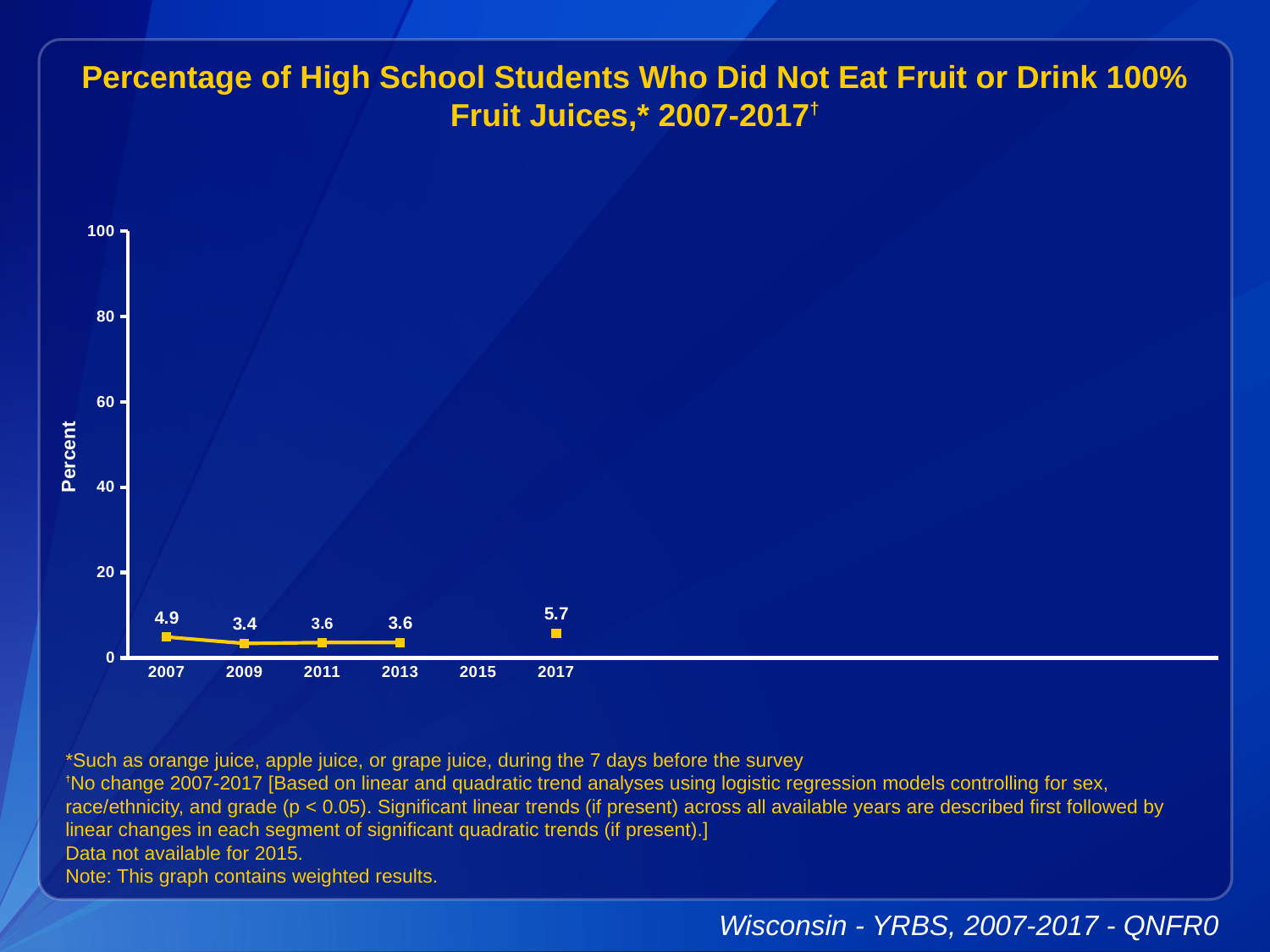
What is the difference between the values for 2017 and 2007? 0.8 What is the label of the y axis? Percent For which year is data not available? 2015 Which year has the highest value? 2017 What is the value for 2009? 3.4 Which is larger, the value for 2007 or the value for 2013? 2007 What is the value for 2007? 4.9 What is the value for 2017? 5.7 Is the value for 2017 greater or less than 20? less How many years are labeled on the x axis? 6 What kind of chart is shown? line chart Which year has the lowest value? 2009